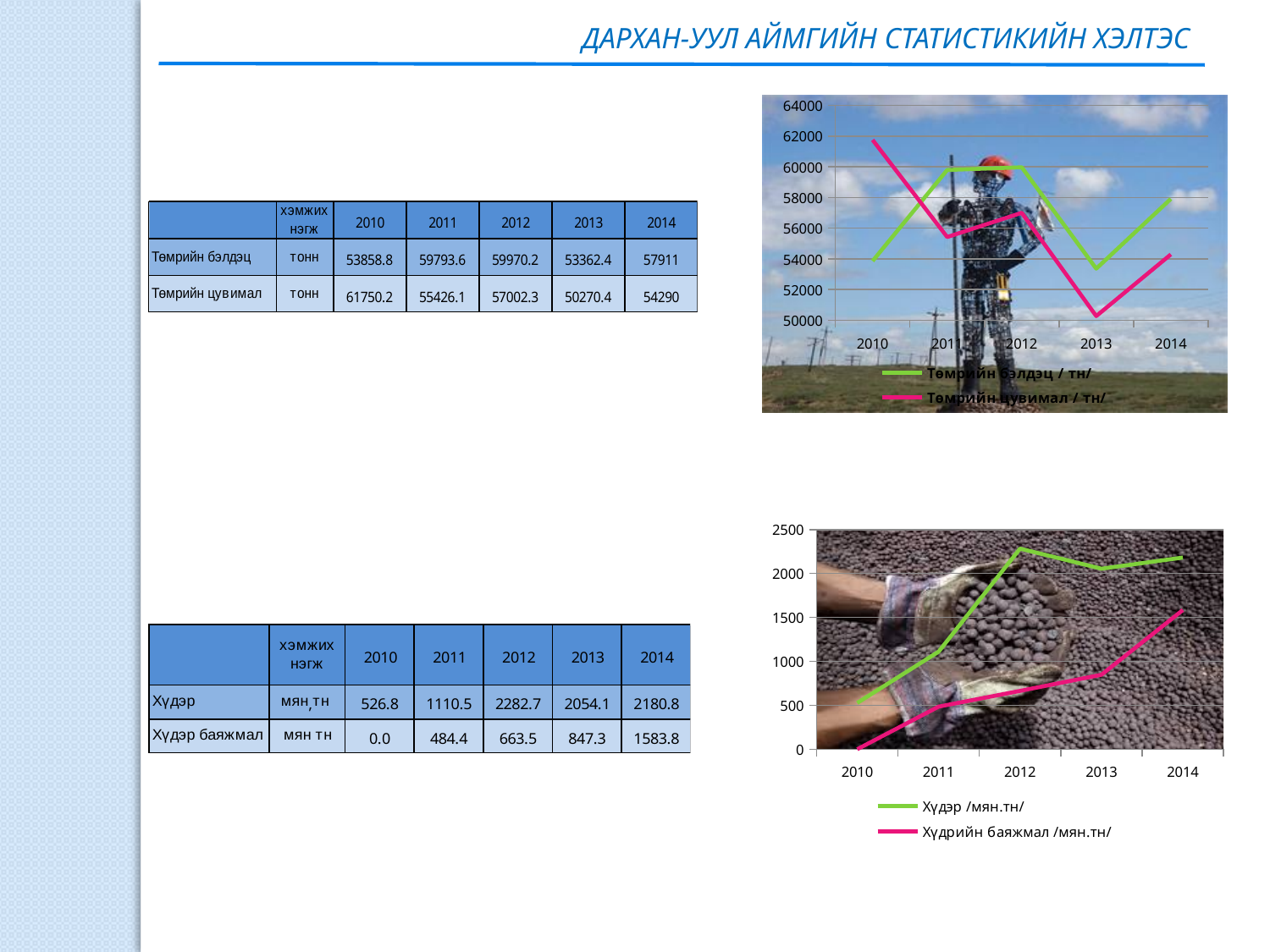
In the top chart, in which year is Төмрийн цувимал /тн/ lowest? 2013 According to the top table, what is the value of Төмрийн бэлдэц in 2014? 57911 In the top chart, is the value for Төмрийн цувимал /тн/ in 2013 greater or less than 52000? less How many years are plotted along the x axis of the top chart? 5 In the top chart, which series has the higher value in 2010, Төмрийн бэлдэц /тн/ or Төмрийн цувимал /тн/? Төмрийн цувимал /тн/ In the top chart, in which year is Төмрийн цувимал /тн/ highest? 2010 What kind of chart is the top chart on the slide? line chart In the bottom chart, in which year is Хүдрийн баяжмал /мян.тн/ highest? 2014 What kind of chart is the bottom chart on the slide? line chart According to the bottom table, what is the difference between Хүдэр and Хүдэр баяжмал in 2014? 597.0 How many series does the legend of the top chart list? 2 In the bottom chart, does Хүдрийн баяжмал /мян.тн/ rise or fall from 2010 to 2014? rise